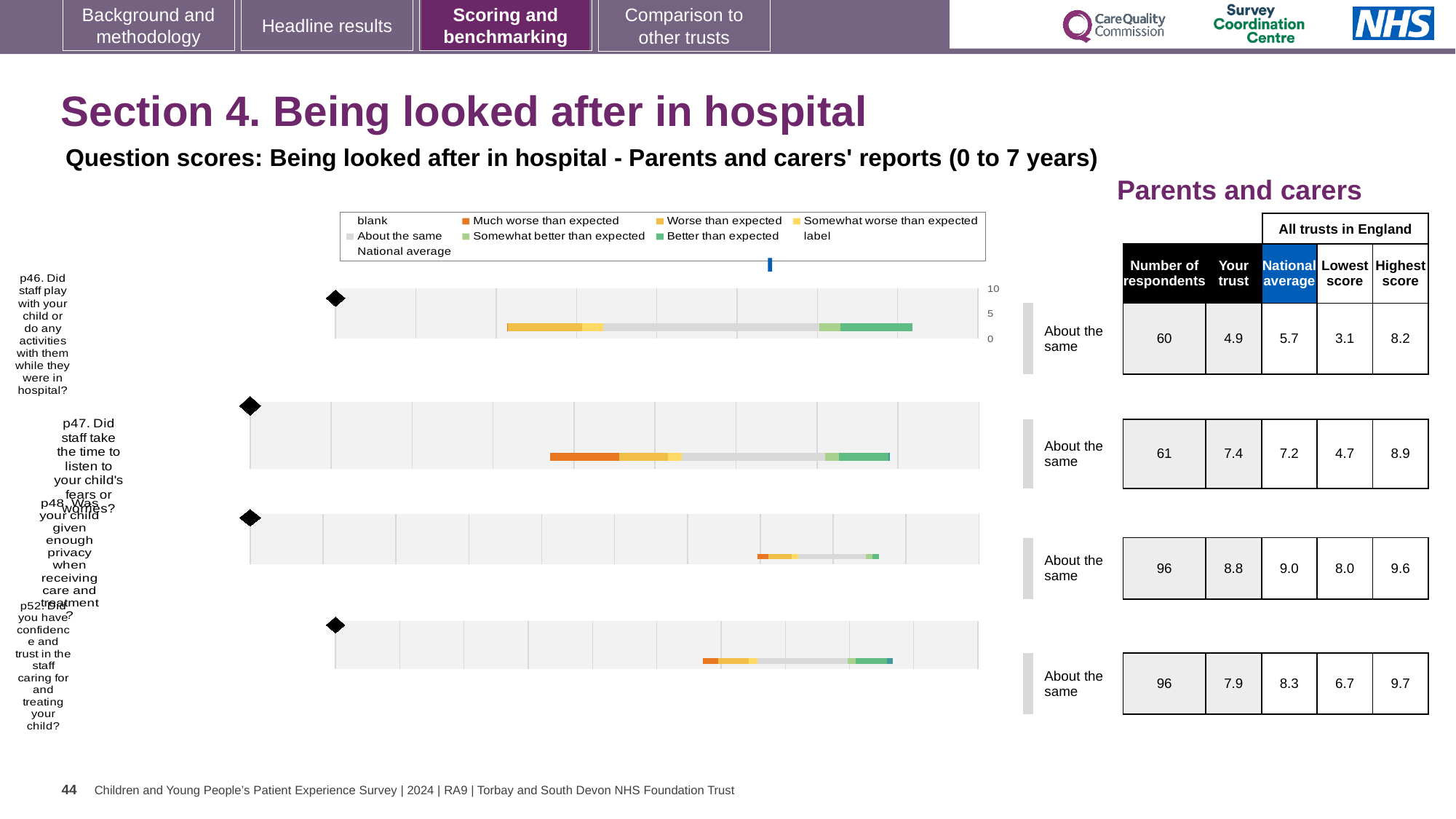
What is the national average shown for p47 (Did staff take the time to listen to your child's fears or worries?)? 7.2 Which colour does the legend use for 'Much worse than expected'? orange What is the 'Your trust' score shown for p46 (Did staff play with your child or do any activities with them while they were in hospital?)? 4.9 For p48, which is larger: the 'Your trust' score or the national average? National average How many respondents are shown for p48 (Was your child given enough privacy when receiving care and treatment?)? 96 What is the highest tick value shown on the axis of the p46 chart? 10 Which of the four questions has the lowest 'Your trust' score? p46 Which of the four questions has the highest 'Your trust' score? p48 What is the difference between the national average and the 'Your trust' score for p46? 0.8 How many question charts are shown on the slide? 4 What kind of chart is used for each question on this slide? bar chart What is the highest score across all trusts in England shown for p52 (Did you have confidence and trust in the staff caring for and treating your child?)? 9.7